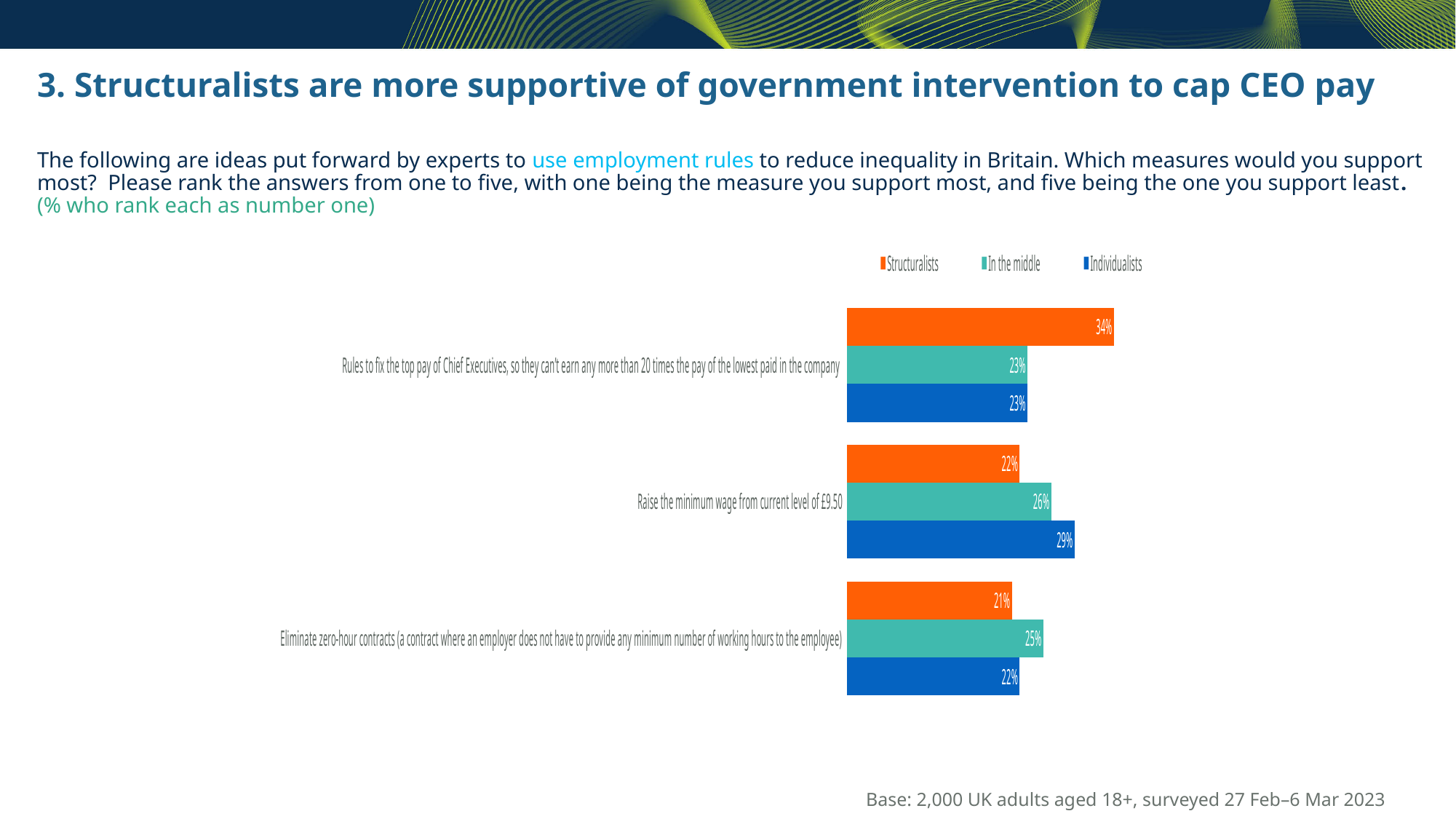
What is the difference between the Structuralists and Individualists values for 'Rules to fix the top pay of Chief Executives'? 11 percentage points What percentage of the 'In the middle' group rank 'Eliminate zero-hour contracts' as number one? 25% What percentage of Individualists rank 'Raise the minimum wage from current level of £9.50' as number one? 29% Which group has the lowest share ranking 'Raise the minimum wage from current level of £9.50' as number one? Structuralists How many measures (categories) are shown in the chart? 3 What kind of chart is shown on the slide? Bar chart For 'Eliminate zero-hour contracts', which is larger: the 'In the middle' value or the Individualists value? In the middle How many series does the legend list? 3 What percentage of Structuralists rank 'Eliminate zero-hour contracts' as number one? 21% Which group has the highest share ranking 'Rules to fix the top pay of Chief Executives' as number one? Structuralists What percentage of Structuralists rank 'Rules to fix the top pay of Chief Executives' as number one? 34% What is the difference between the Individualists and Structuralists values for 'Raise the minimum wage from current level of £9.50'? 7 percentage points